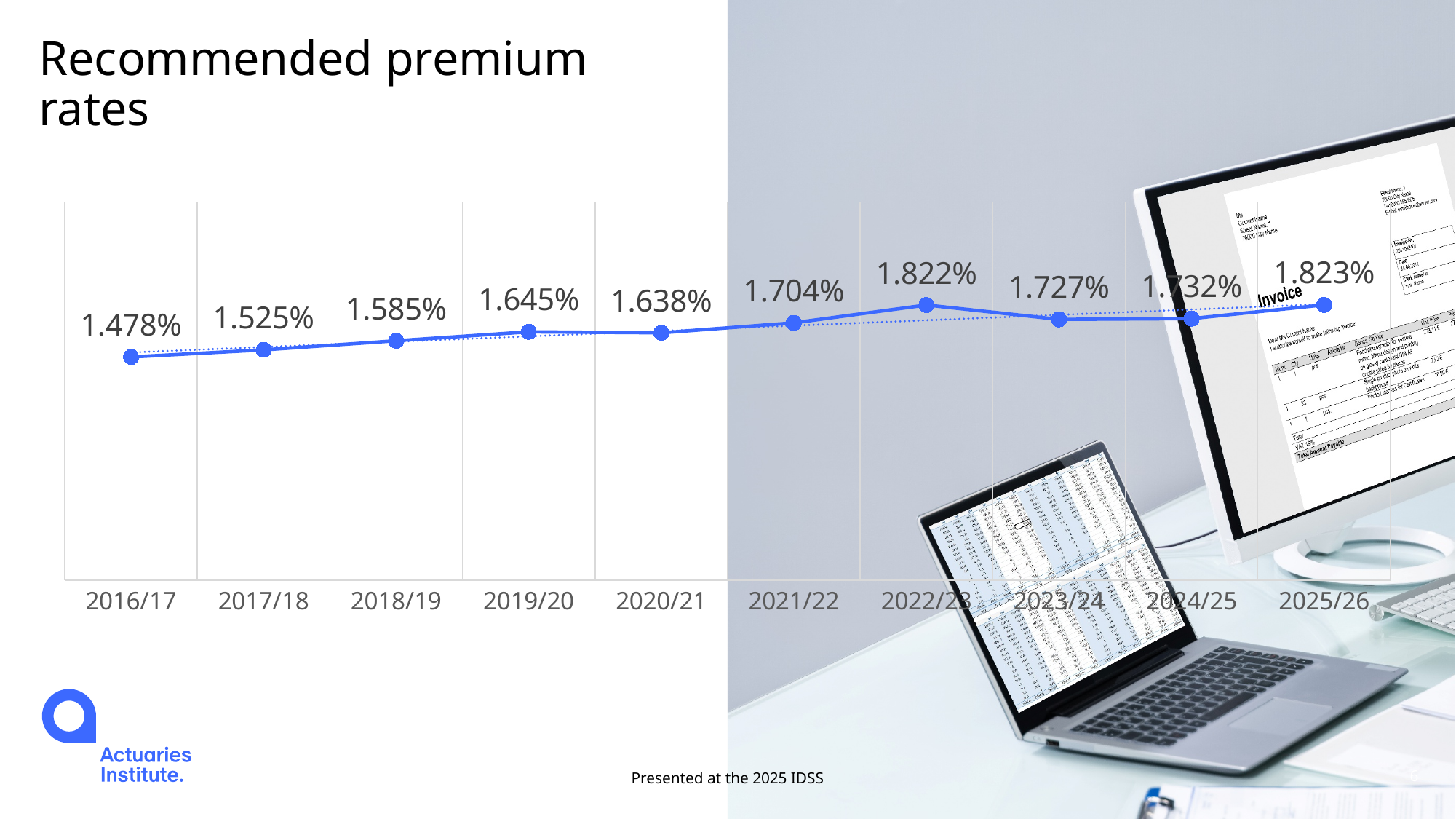
What is the recommended premium rate for 2016/17? 1.478% What is the recommended premium rate for 2020/21? 1.638% Which is larger, the recommended premium rate for 2019/20 or 2020/21? 2019/20 What is the difference between the recommended premium rate for 2025/26 and 2016/17? 0.345% Do the recommended premium rates generally rise or fall from 2016/17 to 2025/26? Rise What is the difference between the recommended premium rate for 2022/23 and 2023/24? 0.095% Which year has the highest recommended premium rate? 2025/26 What is the recommended premium rate for 2024/25? 1.732% How many years are plotted on the chart? 10 What kind of chart is shown on the slide? Line chart What is the recommended premium rate for 2022/23? 1.822% Which year has the lowest recommended premium rate? 2016/17